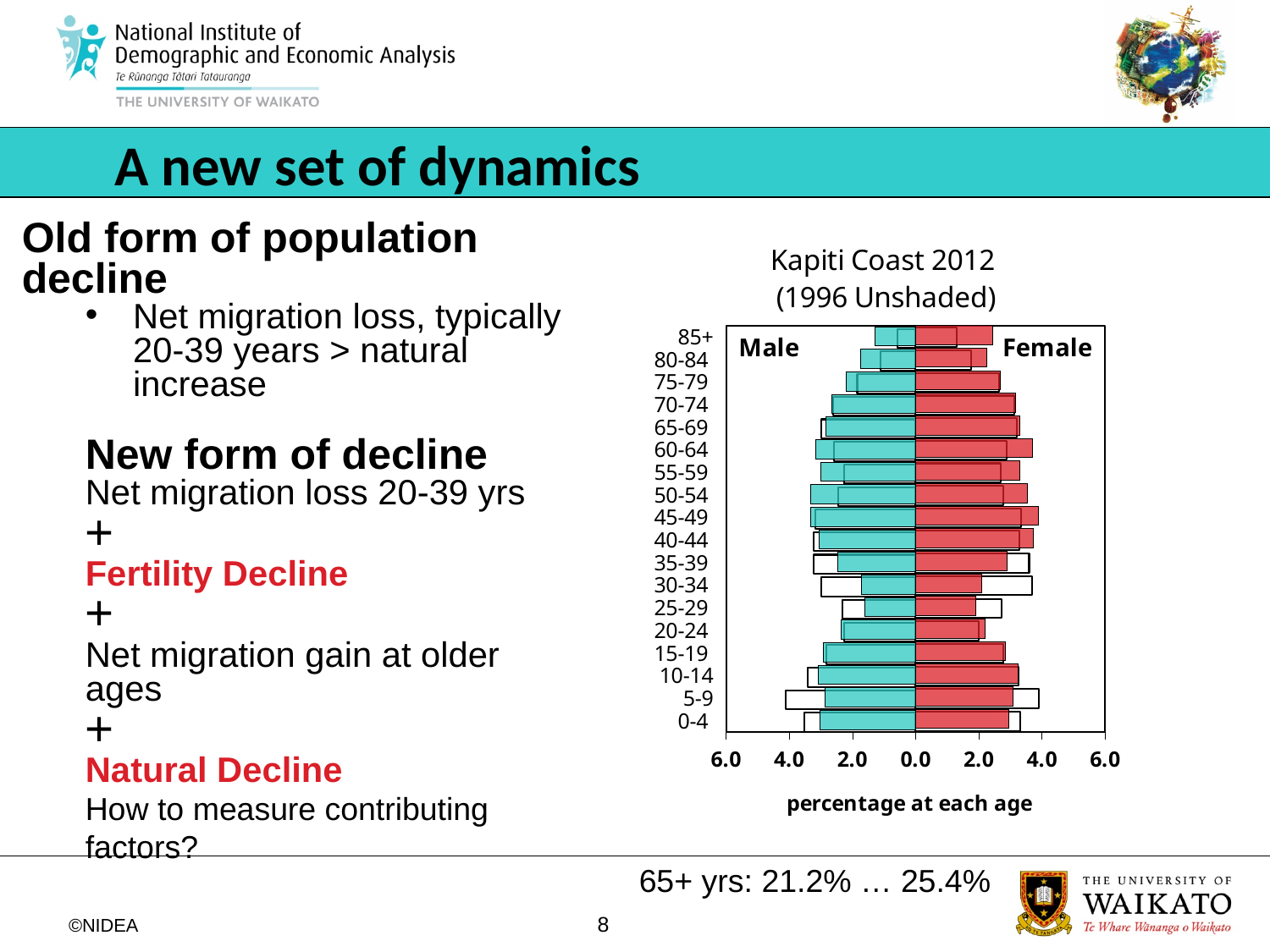
What is the title of the chart on the slide? Kapiti Coast 2012 (1996 Unshaded) What type of chart is shown on the slide? Bar chart Is the 2012 female value for the 0-4 age group greater or less than 4.0? less Is the 2012 male value for the 85+ age group greater or less than 2.0? less Which is larger in 2012: the female value for 45-49 or the female value for 25-29? 45-49 Is the 2012 male value for the 30-34 age group greater or less than 2.0? less Which age group has the shortest male bar for 2012? 85+ What is the label of the horizontal axis of the chart? percentage at each age Which is larger in 2012: the male value for 45-49 or the male value for 85+? 45-49 How many age groups are shown on the vertical axis of the chart? 18